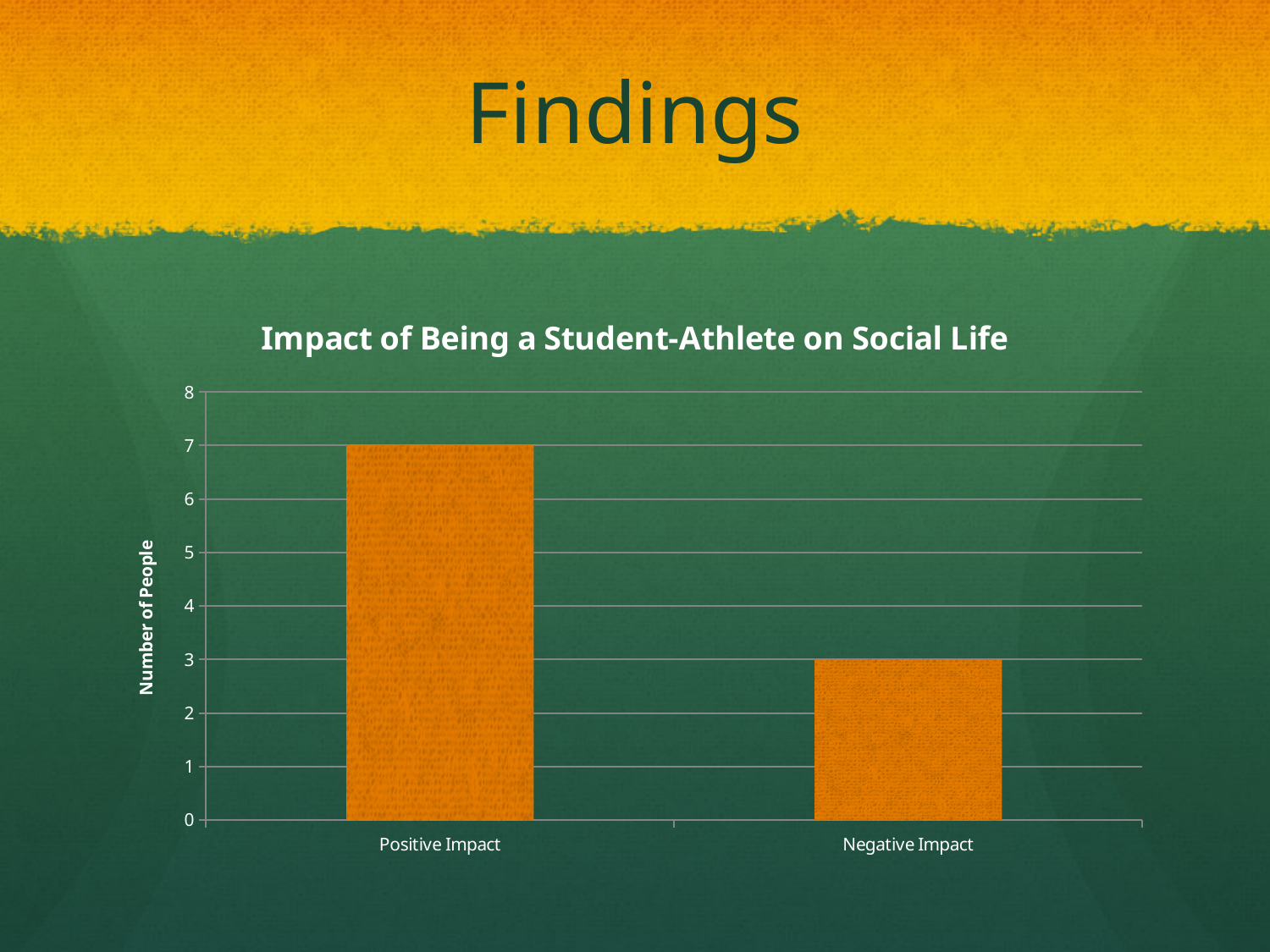
How many categories are shown in the chart? 2 Is the value for Positive Impact greater or less than 5? greater Which category has the lowest number of people? Negative Impact Which is larger, the value for Positive Impact or the value for Negative Impact? Positive Impact Which category has the highest number of people? Positive Impact What is the title of the chart? Impact of Being a Student-Athlete on Social Life What is the label of the vertical axis? Number of People Is the value for Negative Impact greater or less than 4? less What is the number of people for Positive Impact? 7 What is the number of people for Negative Impact? 3 What is the difference in number of people between Positive Impact and Negative Impact? 4 What type of chart is shown on the slide? bar chart